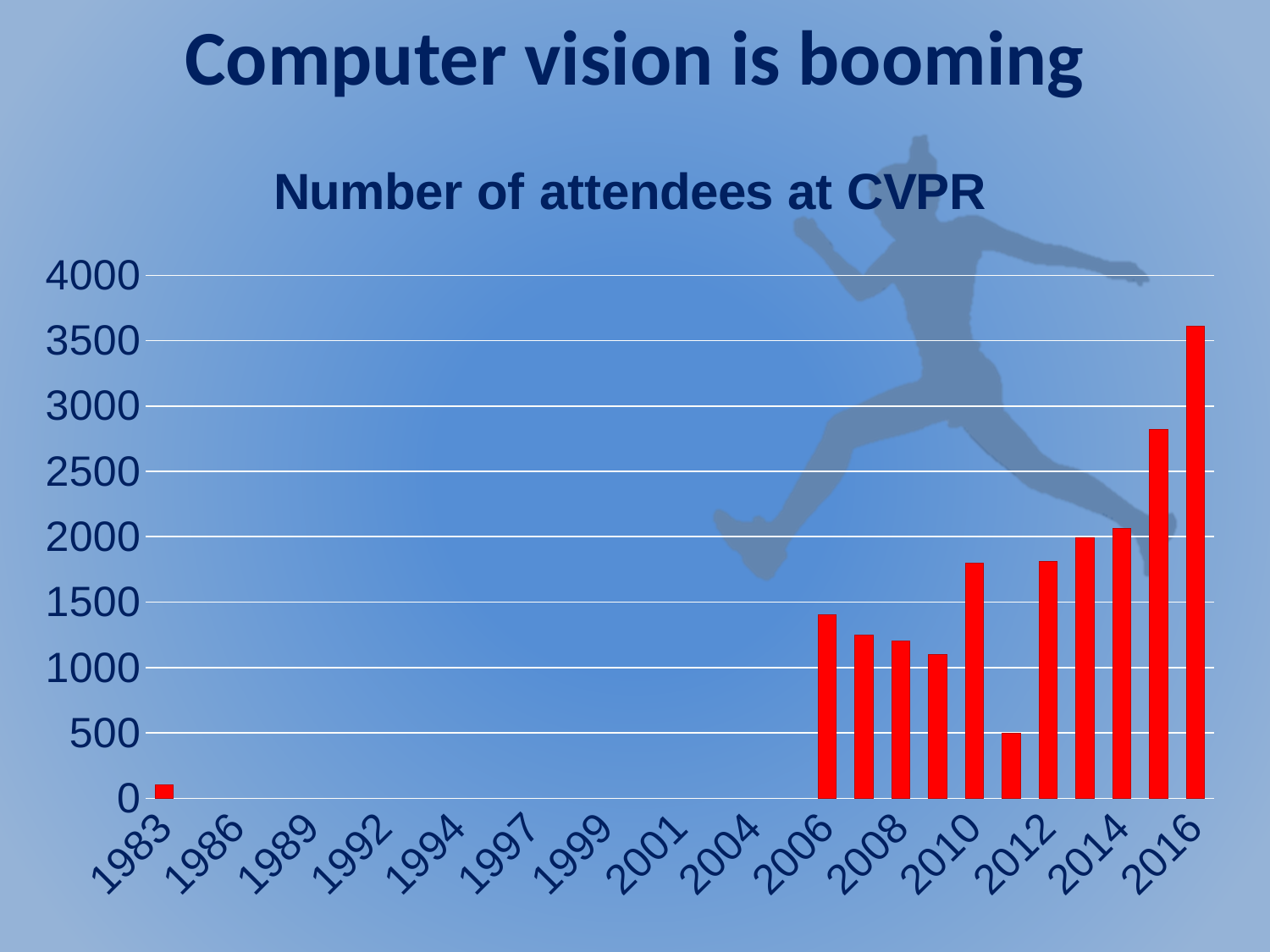
What is the title of the chart? Number of attendees at CVPR What colour are the bars in the chart? red Which year has the highest number of attendees? 2016 Is the number of attendees in 2016 greater or less than 3000? greater Is the number of attendees in 2010 greater or less than 1500? greater Which labeled year has the lowest number of attendees? 1983 What type of chart is shown on the slide? bar chart Is the number of attendees in 2006 greater or less than 1000? greater Which year had more attendees, 2014 or 2016? 2016 Overall, do the number of attendees rise or fall from 2006 to 2016? rise